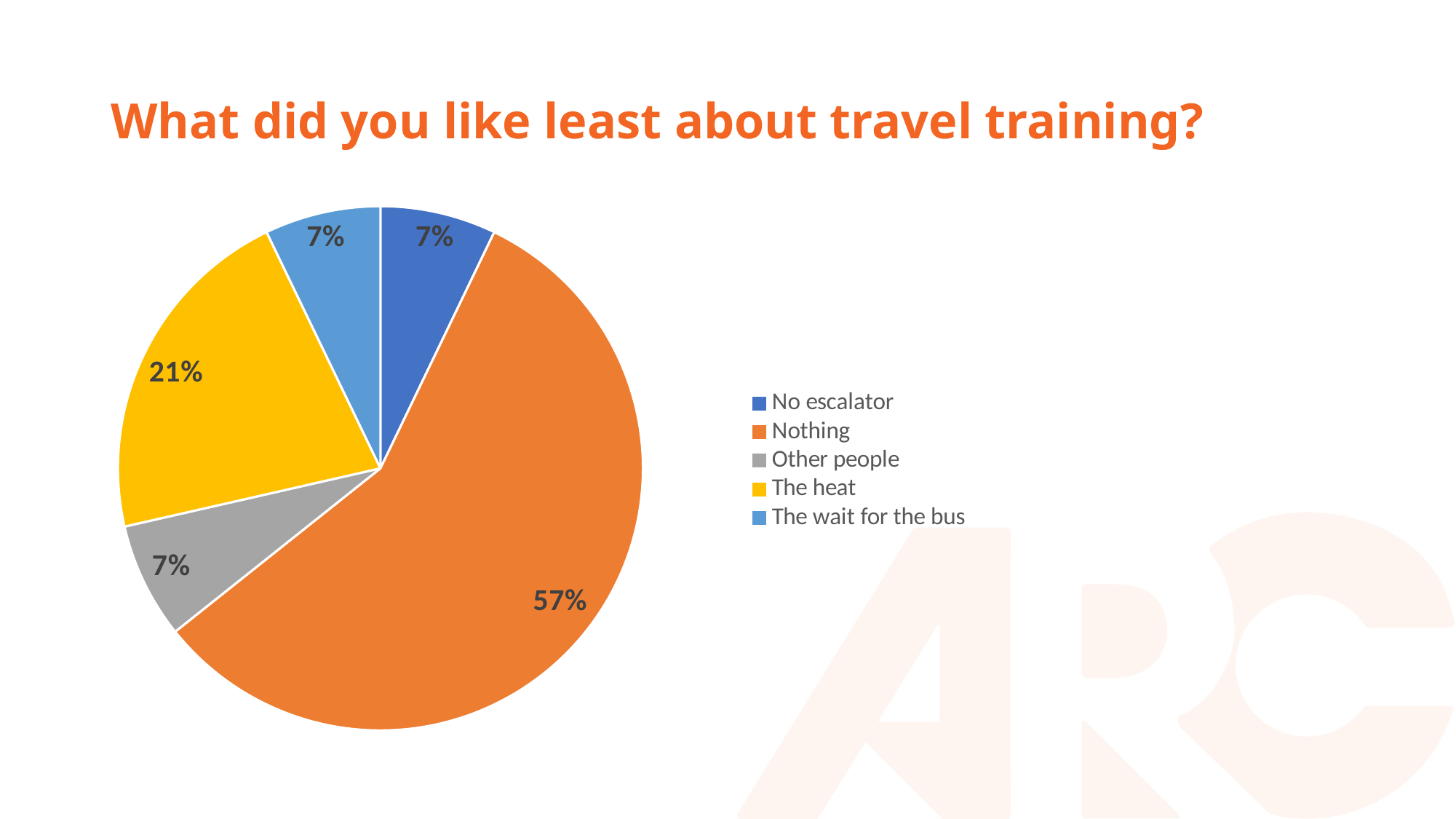
Which category has the largest slice of the pie? Nothing What share of the pie is 'The heat'? 21% What is the difference between the shares for 'Nothing' and 'The heat'? 36% How many slices does the pie chart have? 5 What share of the pie is 'Other people'? 7% What kind of chart is shown on the slide? pie chart What colour is the slice for 'The heat'? yellow What share of the pie is 'No escalator'? 7% Which is larger, the share for 'The heat' or the share for 'Other people'? The heat What is the title of the chart? What did you like least about travel training?